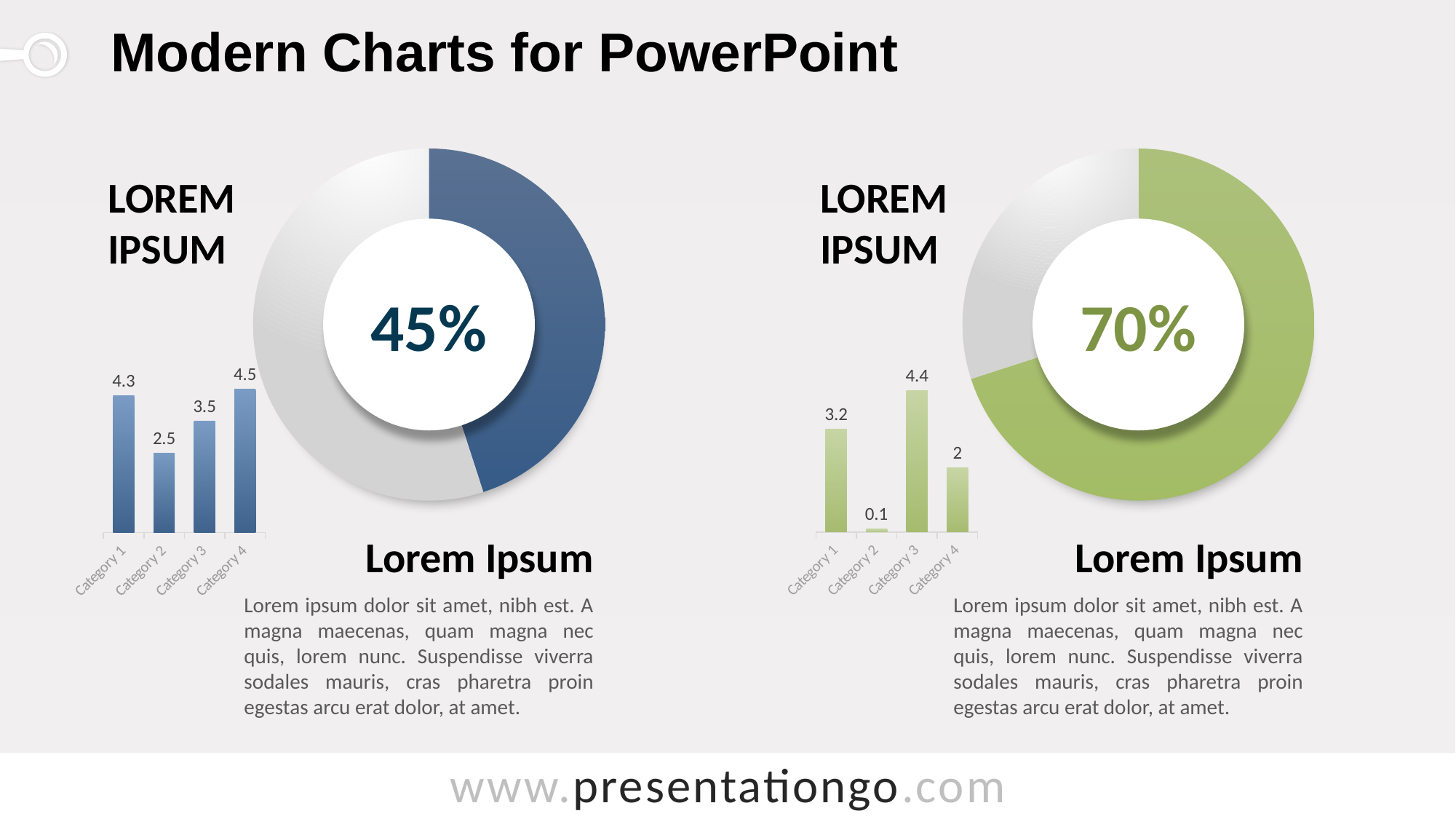
In the blue bar chart on the left side of the slide, which category has the lowest value? Category 2 In the green bar chart on the right side of the slide, which is larger, the value for Category 1 or the value for Category 4? Category 1 What kind of chart is the small chart with four labelled categories on the left side of the slide? Bar chart In the green bar chart on the right side of the slide, what is the difference between the values for Category 3 and Category 2? 4.3 What percentage is shown in the centre of the green donut chart on the right side of the slide? 70% In the green bar chart on the right side of the slide, what is the value for Category 3? 4.4 In the blue bar chart on the left side of the slide, which category has the highest value? Category 4 In the blue bar chart on the left side of the slide, what is the value for Category 2? 2.5 What percentage is shown in the centre of the blue donut chart on the left side of the slide? 45% In the blue bar chart on the left side of the slide, what is the difference between the values for Category 4 and Category 1? 0.2 In the green bar chart on the right side of the slide, which category has the lowest value? Category 2 How many categories are shown in the green bar chart on the right side of the slide? 4